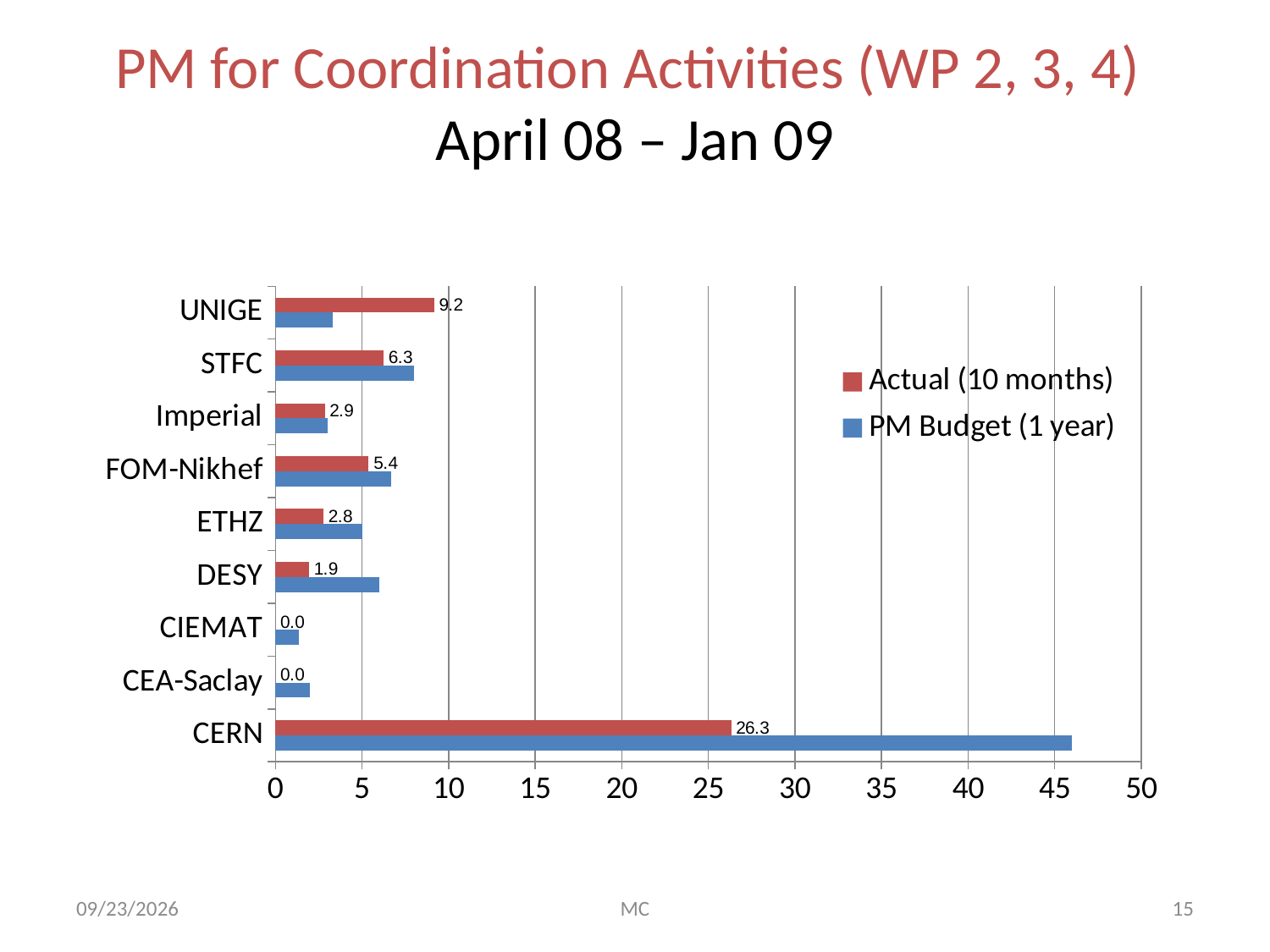
What is the Actual (10 months) value for FOM-Nikhef? 5.4 What is the difference between the Actual (10 months) values for CERN and UNIGE? 17.1 How many institutes are shown on the chart? 9 Which institute has the highest Actual (10 months) value? CERN Which has a larger Actual (10 months) value, STFC or Imperial? STFC How many series does the legend list? 2 Is the PM Budget (1 year) value for STFC greater or less than 5? greater What is the Actual (10 months) value for DESY? 1.9 What kind of chart is shown on the slide? Bar chart Is the PM Budget (1 year) value for CERN greater or less than 45? greater What is the Actual (10 months) value for UNIGE? 9.2 What is the Actual (10 months) value for CERN? 26.3